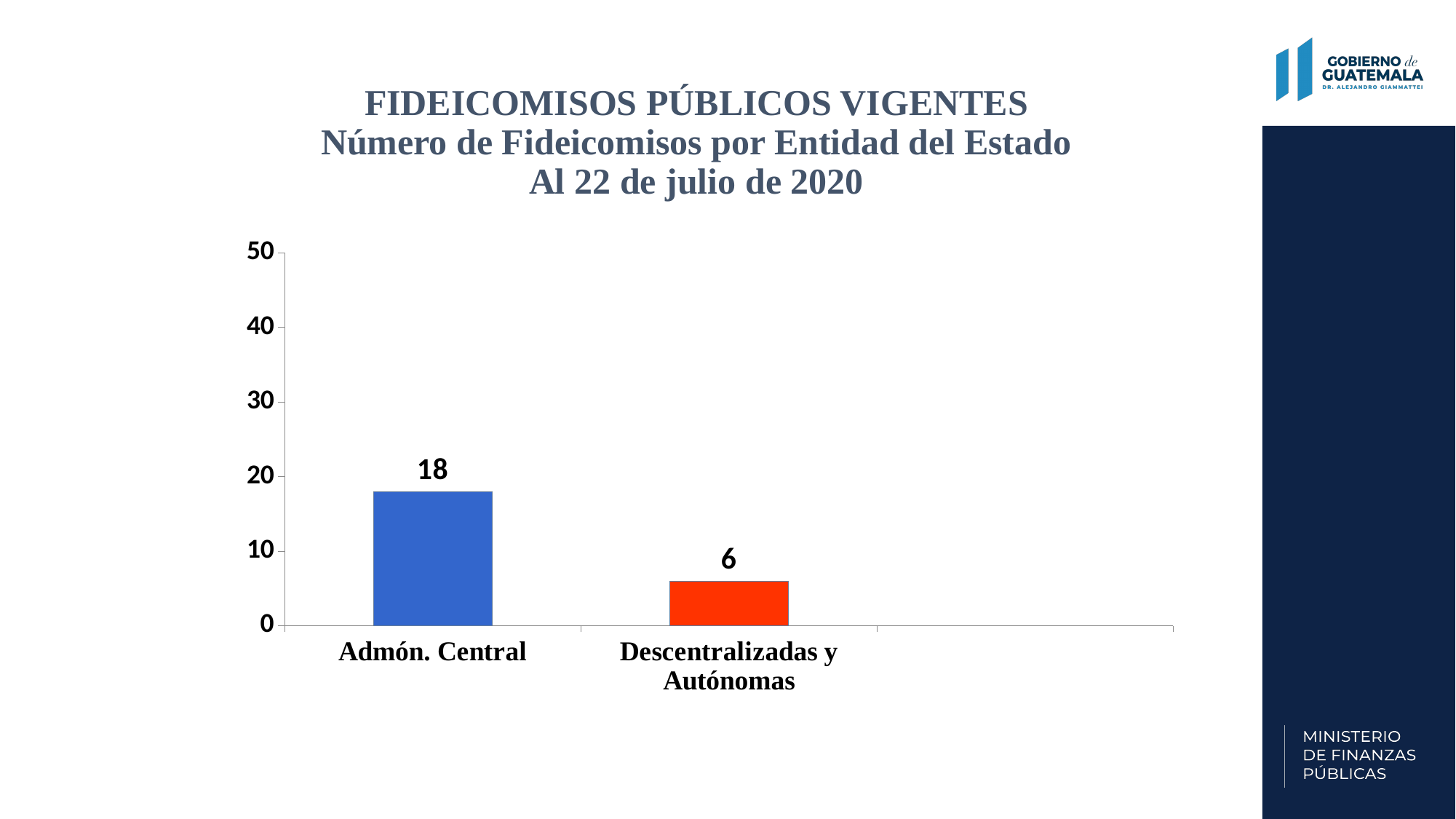
What kind of chart is shown on the slide? Bar chart How many categories are shown on the chart? 2 Which entity has the lowest number of fideicomisos? Descentralizadas y Autónomas Which has more fideicomisos, Admón. Central or Descentralizadas y Autónomas? Admón. Central Which entity has the highest number of fideicomisos? Admón. Central What is the maximum value shown on the vertical axis of the chart? 50 What is the number of fideicomisos for Admón. Central? 18 Is the value for Admón. Central greater or less than 20? less What is the difference between the number of fideicomisos for Admón. Central and for Descentralizadas y Autónomas? 12 Is the value for Descentralizadas y Autónomas greater or less than 10? less What is the number of fideicomisos for Descentralizadas y Autónomas? 6 What is the total number of fideicomisos across both entities shown? 24